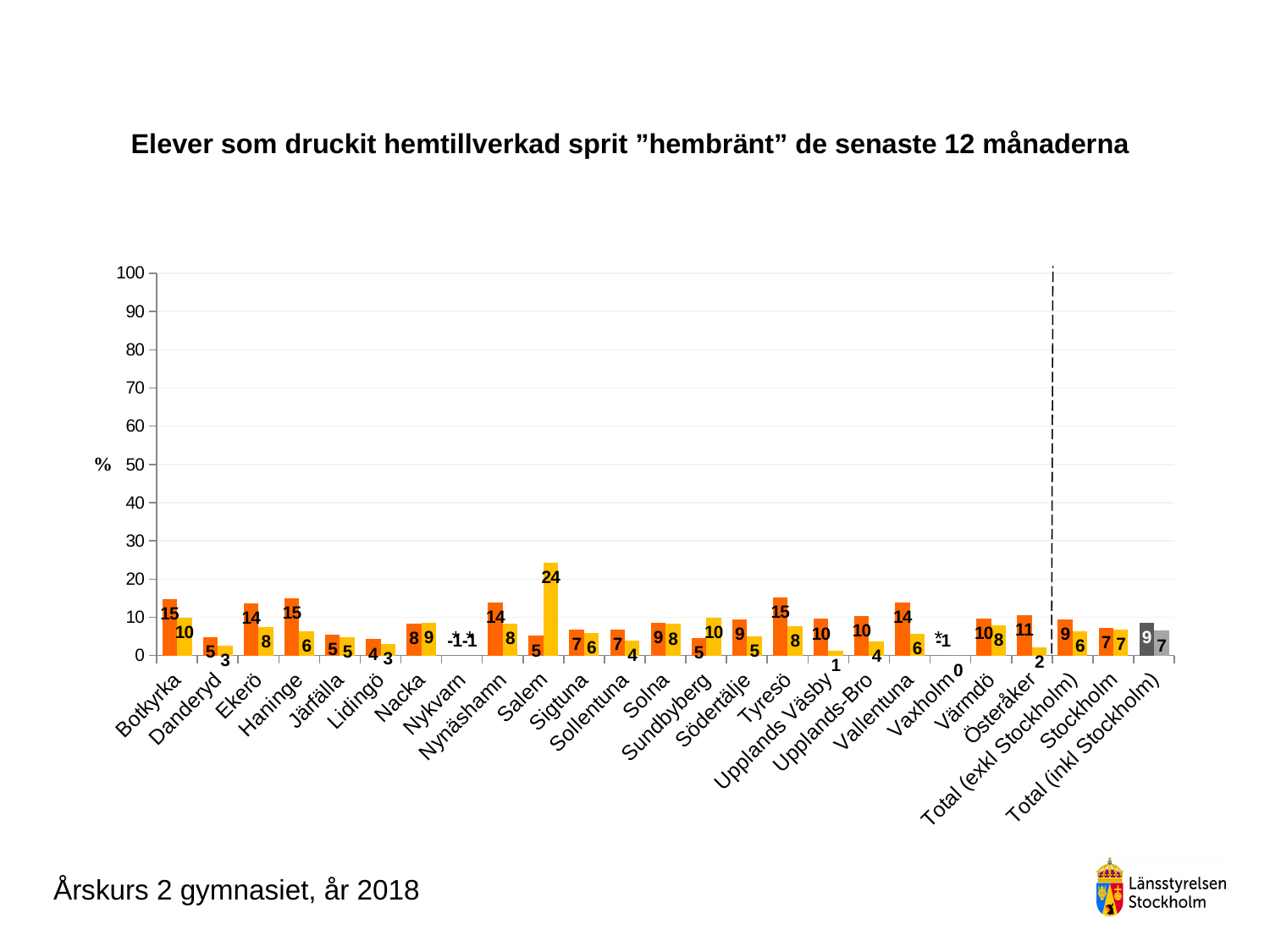
What is the difference between the orange and yellow bars for Botkyrka? 5 What is the value of the yellow bar for Sundbyberg? 10 For Salem, which bar is larger, the orange or the yellow one? yellow What is the value of the yellow bar for Salem? 24 Is the value of the yellow bar for Salem greater or less than 20? greater Which category has the highest bar in the chart? Salem What is the value of the yellow bar for Österåker? 2 What is the value of the orange bar for Botkyrka? 15 What is the value of the orange bar for Total (exkl Stockholm)? 9 What is the title of the chart? Elever som druckit hemtillverkad sprit "hembränt" de senaste 12 månaderna What type of chart is shown on the slide? bar chart How many categories are shown on the x axis? 25